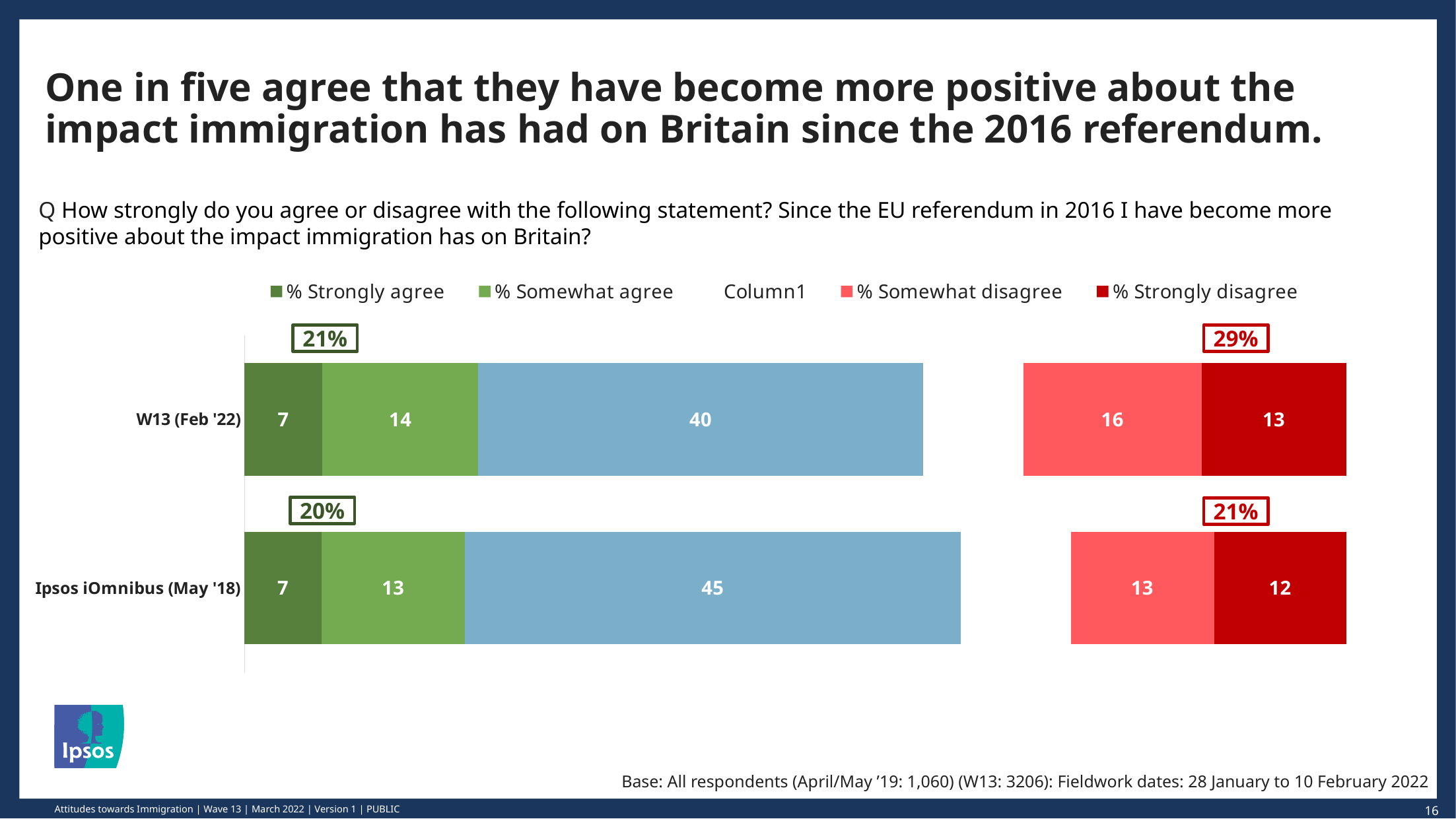
What is the % Somewhat agree value for W13 (Feb '22)? 14 What is the boxed total agree percentage shown above the W13 (Feb '22) bar? 21% Which category has the larger % Somewhat disagree value, W13 (Feb '22) or Ipsos iOmnibus (May '18)? W13 (Feb '22) What is the % Strongly disagree value for Ipsos iOmnibus (May '18)? 12 How many categories (bars) are shown in the chart? 2 How many series does the legend list? 5 What kind of chart is shown on the slide? Stacked bar chart What is the total of the % Strongly agree and % Somewhat agree segments for Ipsos iOmnibus (May '18)? 20 What is the % Somewhat disagree value for W13 (Feb '22)? 16 What is the boxed total disagree percentage shown above the Ipsos iOmnibus (May '18) bar? 21%